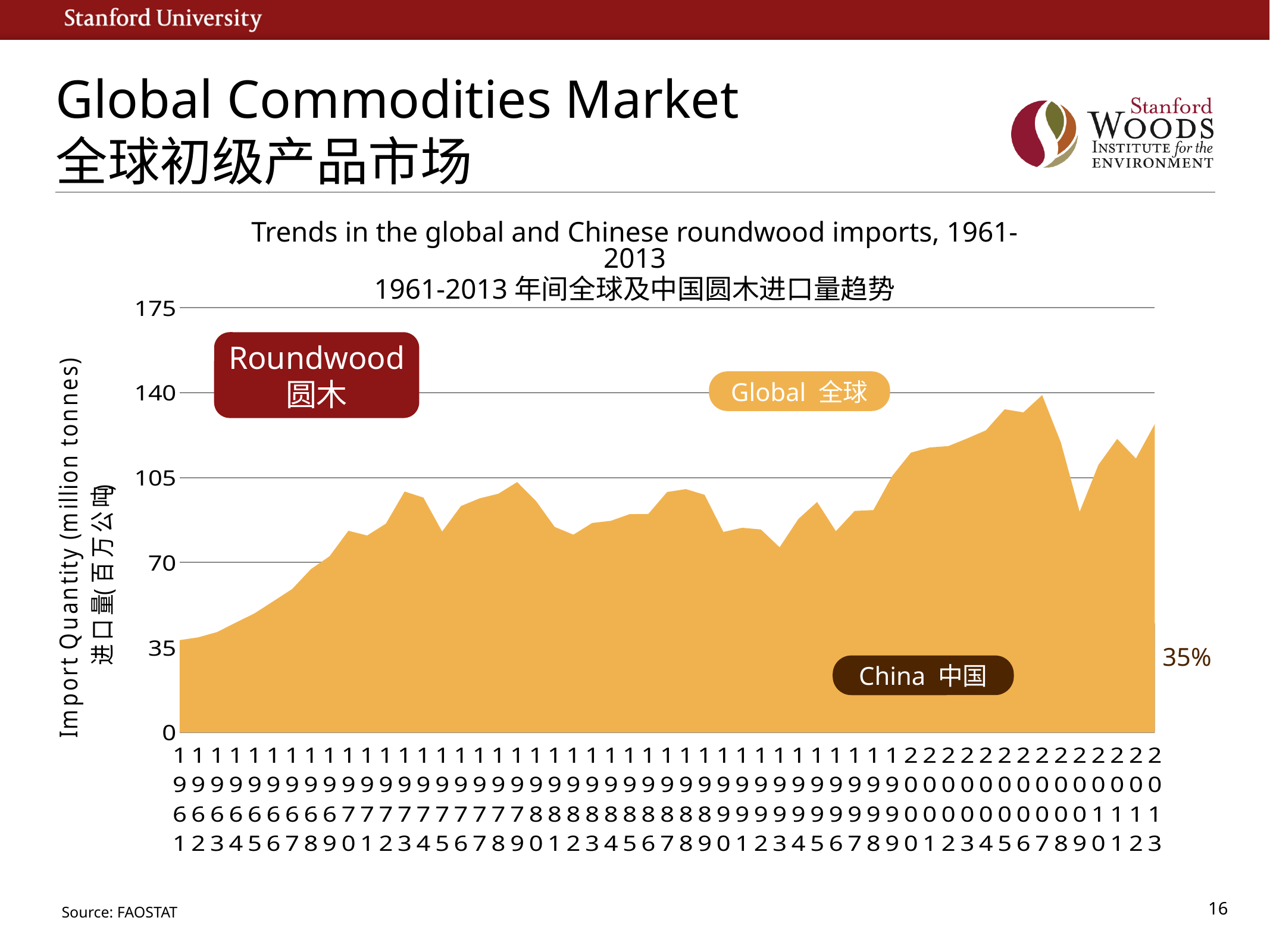
Which year has the highest import quantity? 2007 Is the import quantity for 2013 greater or less than 105? greater What kind of chart is shown on the slide? area chart Which year has the lowest import quantity? 1961 Is the import quantity for 2009 greater or less than 105? less Is the import quantity for 1990 greater or less than 70? greater What is the label of the vertical axis? Import Quantity (million tonnes) What is the highest value shown on the vertical axis? 175 What is the title of the chart? Trends in the global and Chinese roundwood imports, 1961-2013 How many years are plotted along the x axis? 53 Overall, do import quantities rise or fall from 1961 to 2013? rise